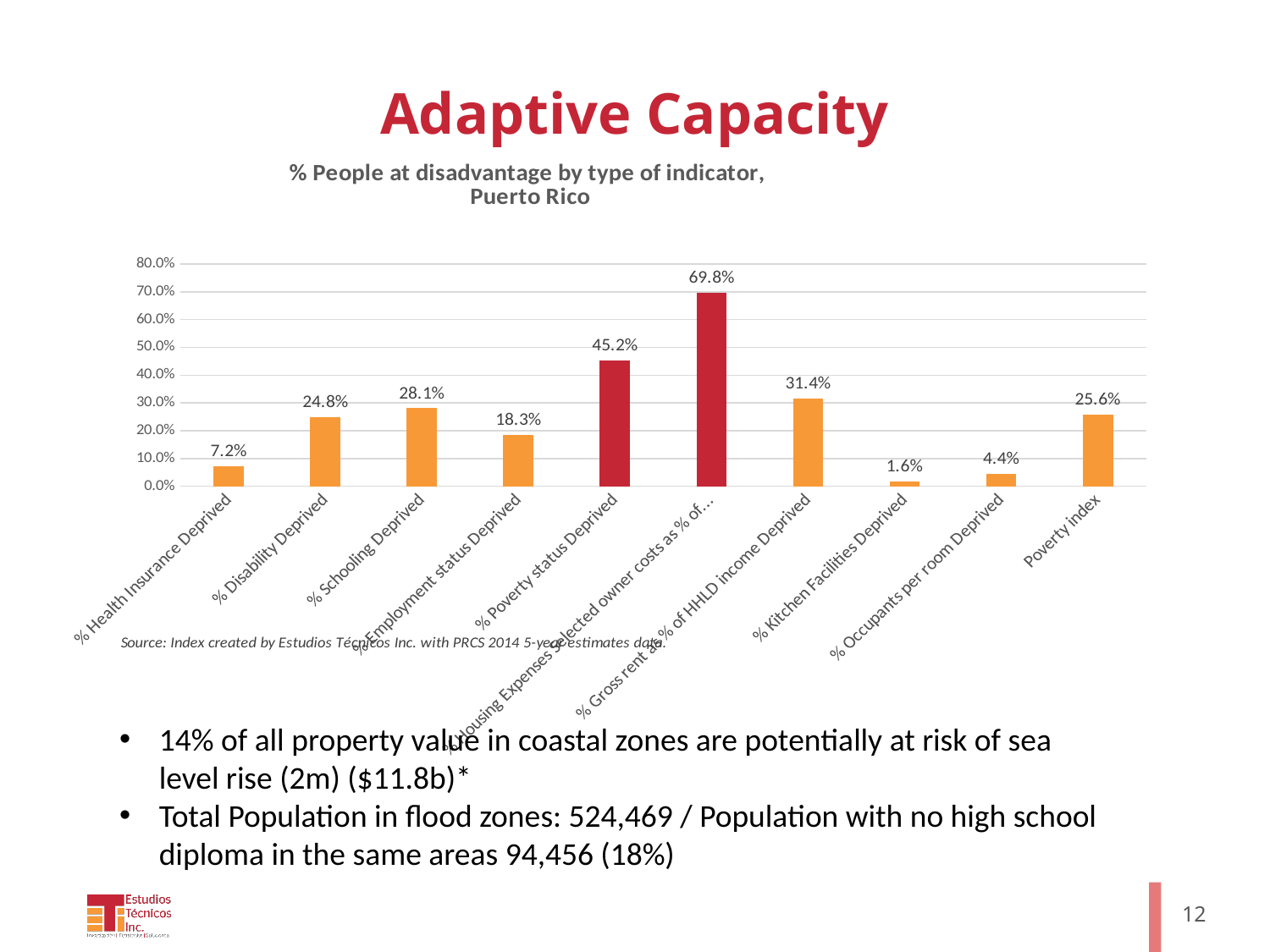
Which category has the lowest value? % Kitchen Facilities Deprived How many categories are shown in the chart? 10 What kind of chart is shown on the slide? Bar chart What is the value for % Gross rent as % of HHLD income Deprived? 31.4% What is the value for % Disability Deprived? 24.8% What is the value for % Poverty status Deprived? 45.2% What is the title of the chart? % People at disadvantage by type of indicator, Puerto Rico What is the value for Poverty index? 25.6% What is the value of the tallest bar in the chart? 69.8% Which is larger, % Schooling Deprived or % Gross rent as % of HHLD income Deprived? % Gross rent as % of HHLD income Deprived What is the difference between % Poverty status Deprived and % Employment status Deprived? 26.9% What is the value for % Health Insurance Deprived? 7.2%